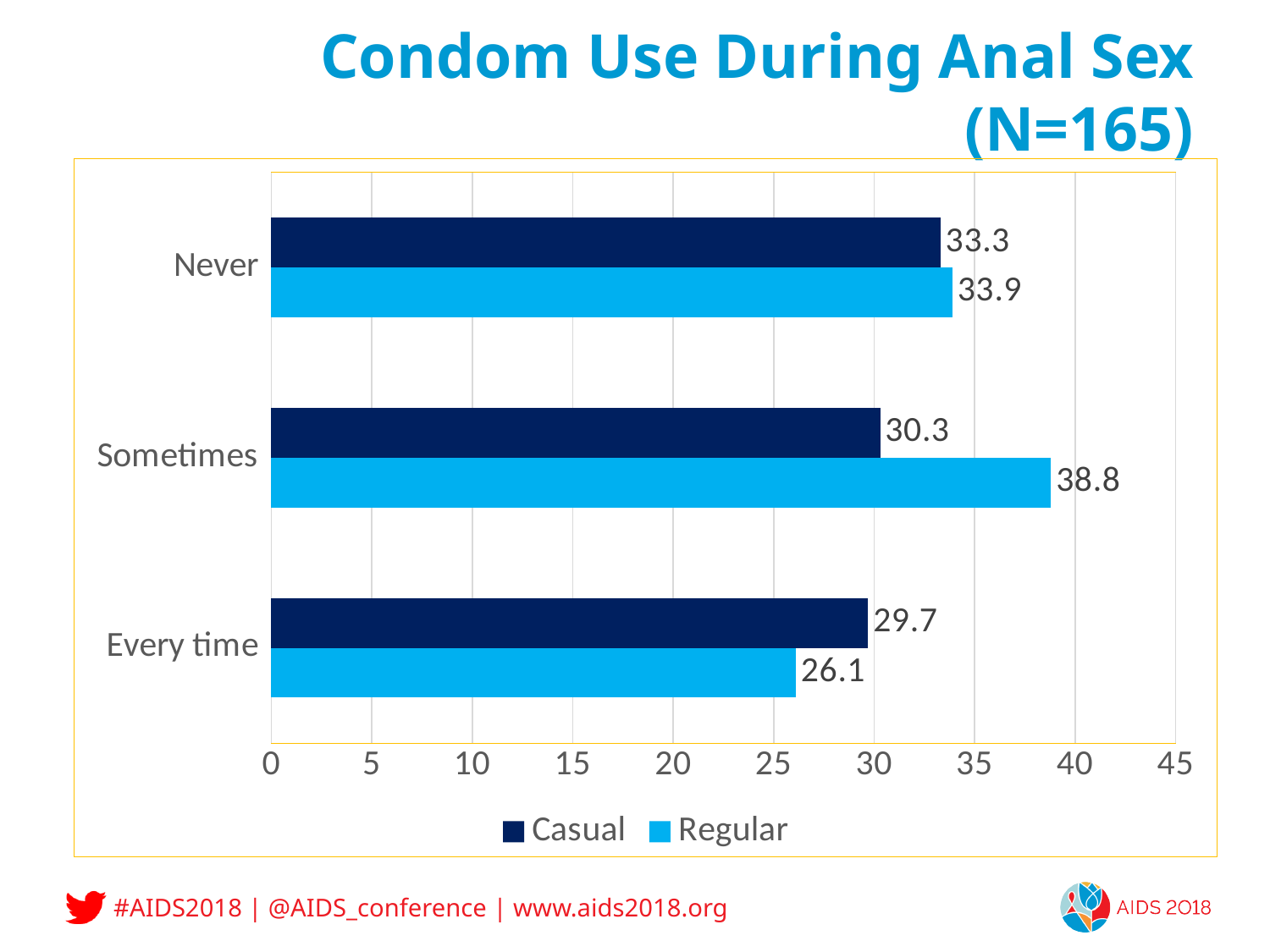
How many series does the legend list? 2 Which category has the highest Regular value? Sometimes What is the Casual value for Every time? 29.7 What is the Regular value for Sometimes? 38.8 Is the Regular value for Sometimes greater or less than 35? greater How many categories are shown on the chart? 3 What is the Casual value for Never? 33.3 For Every time, which series has the larger value, Casual or Regular? Casual What kind of chart is shown on the slide? Bar chart What is the Regular value for Every time? 26.1 What is the difference between the Regular and Casual values for Sometimes? 8.5 Which category has the lowest Regular value? Every time